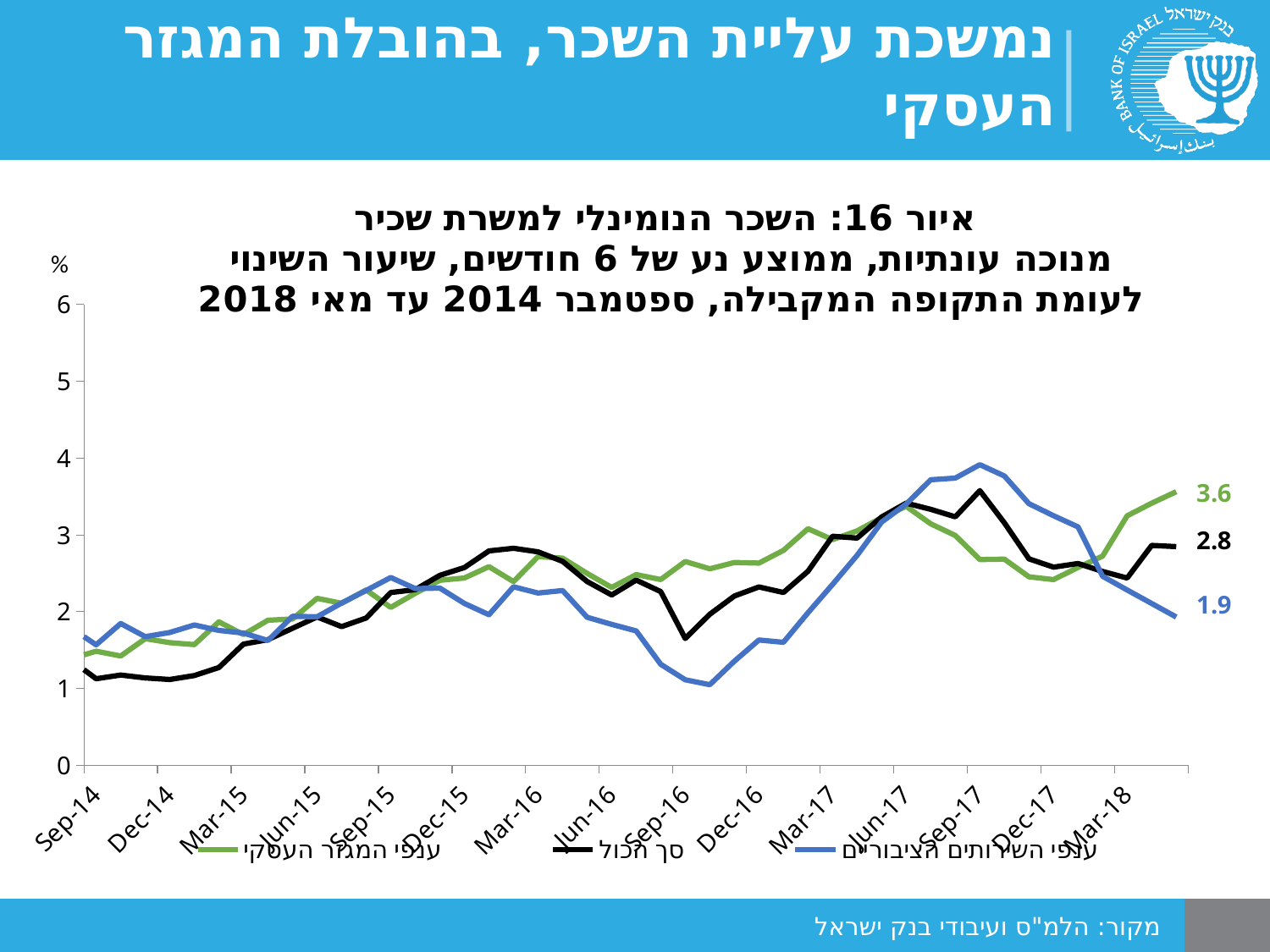
How many series does the legend list? 3 What is the difference between the final values of the green line (3.6) and the blue line (1.9)? 1.7 Which series has the lowest value at the end of the period (May 2018)? ענפי השירותים הציבוריים What unit is shown on the y axis of the chart? % What is the final labelled value for the green line (ענפי המגזר העסקי)? 3.6 What is the final labelled value for the blue line (ענפי השירותים הציבוריים)? 1.9 What is the final labelled value for the black line (סך הכול)? 2.8 At the end of the period, is the value for סך הכול larger or smaller than the value for ענפי המגזר העסקי? smaller Does the blue line (ענפי השירותים הציבוריים) rise or fall between Sep-17 and Mar-18? fall Which series has the highest value at the end of the period (May 2018)? ענפי המגזר העסקי Is the value of the blue line (ענפי השירותים הציבוריים) in Sep-16 greater or less than 2? less What type of chart is shown on the slide? line chart